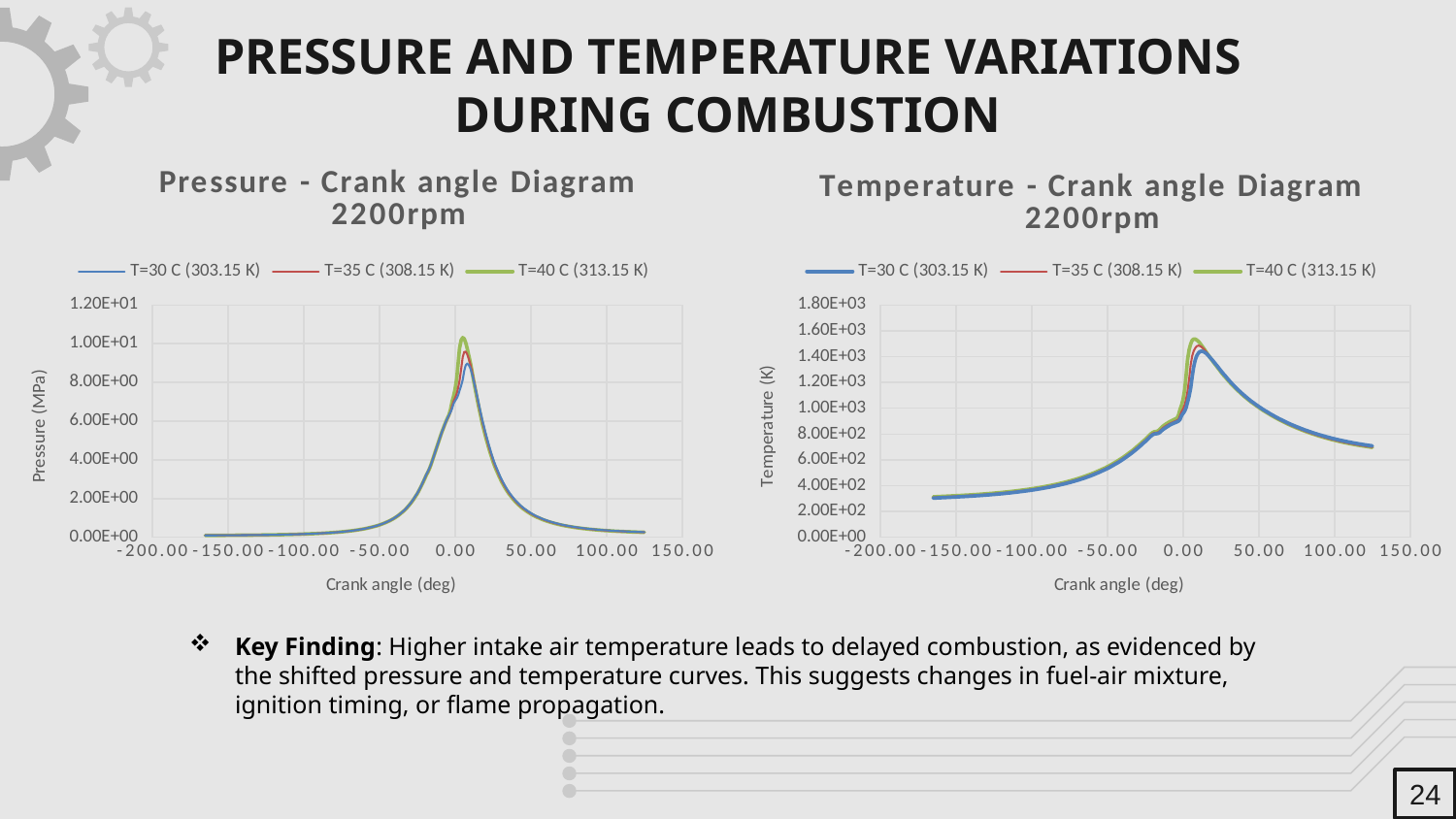
In the Pressure - Crank angle Diagram 2200rpm, after the peak, does the pressure rise or fall as the crank angle increases toward 150.00? fall In the Temperature - Crank angle Diagram 2200rpm, is the peak temperature for T=30 C (303.15 K) greater or less than 1.20E+03? greater In the Temperature - Crank angle Diagram 2200rpm, which series has the higher peak temperature, T=30 C (303.15 K) or T=40 C (313.15 K)? T=40 C (313.15 K) In the Temperature - Crank angle Diagram 2200rpm, is the temperature at a crank angle of -150.00 greater or less than 4.00E+02? less In the Pressure - Crank angle Diagram 2200rpm, is the peak pressure for T=30 C (303.15 K) greater or less than 1.00E+01? less What is the x-axis title of the Temperature - Crank angle Diagram 2200rpm? Crank angle (deg) In the Temperature - Crank angle Diagram 2200rpm, which series has the lowest peak temperature? T=30 C (303.15 K) In the Pressure - Crank angle Diagram 2200rpm, which series reaches the highest peak pressure? T=40 C (313.15 K) How many series does the legend of the Temperature - Crank angle Diagram 2200rpm list? 3 What is the y-axis title of the Pressure - Crank angle Diagram 2200rpm? Pressure (MPa) What kind of chart is the Pressure - Crank angle Diagram 2200rpm? Line chart